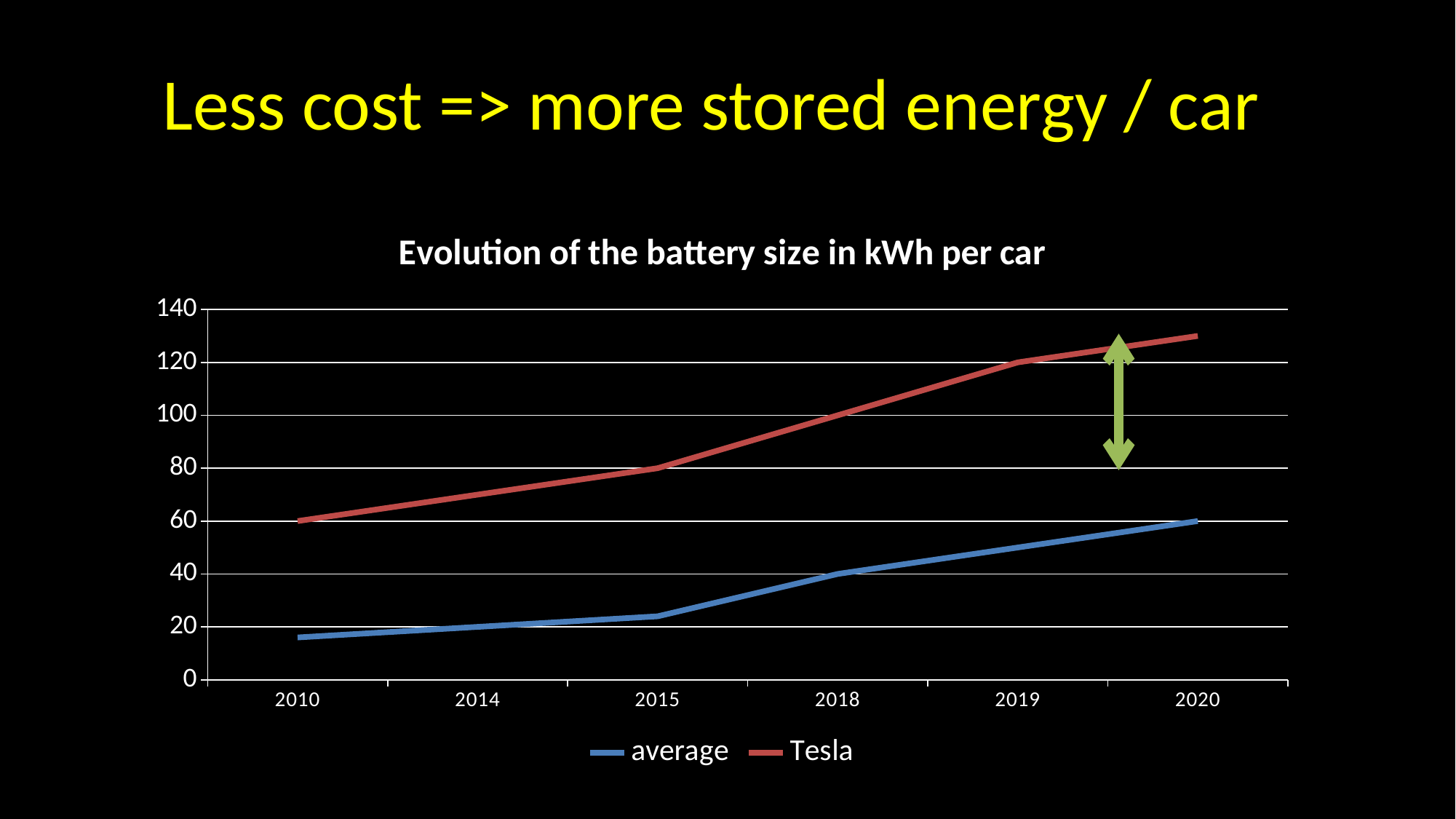
What is the Tesla battery size in 2015? 80 Is the average value for 2010 greater or less than 20? less What is the difference between the Tesla and average battery sizes in 2018? 60 Is the Tesla value for 2020 greater or less than 120? greater What is the Tesla battery size in 2019? 120 What kind of chart is shown on the slide? line chart What is the average battery size in 2018? 40 How many years are shown on the x axis? 6 What is the average battery size in 2020? 60 How many series does the legend list? 2 Do the values for the Tesla series rise or fall from 2010 to 2020? rise What is the Tesla battery size in 2010? 60